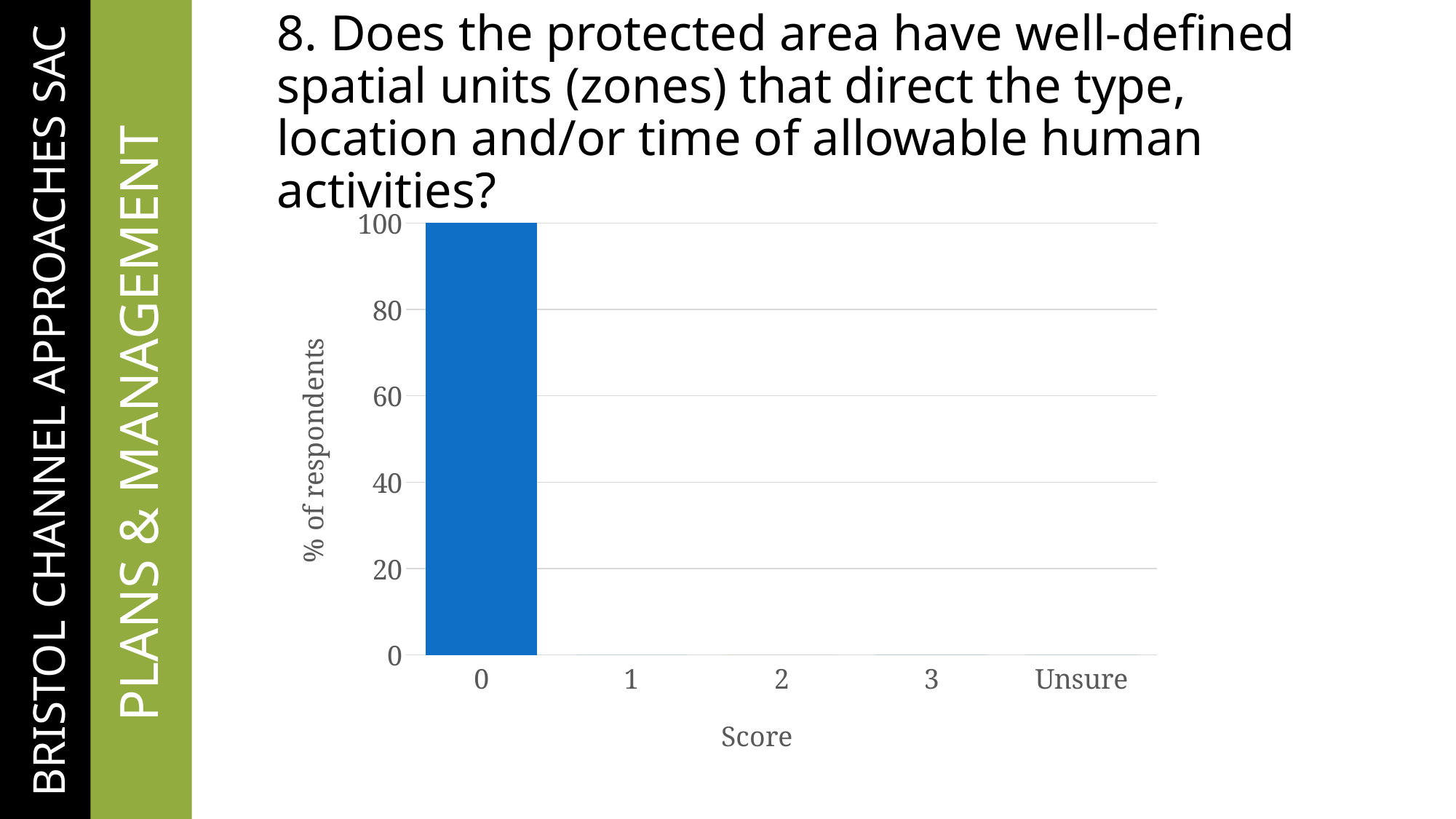
What is the label of the x axis? Score What type of chart is shown on the slide? bar chart What is the % of respondents for score 2? 0 What is the difference in % of respondents between score 0 and score 1? 100 How many score categories are shown on the x axis? 5 Is the value for score 0 greater or less than 80? greater What is the label of the y axis? % of respondents Which score category has the highest % of respondents? 0 What is the % of respondents for score 0? 100 What is the highest value shown on the y axis? 100 Which has a larger % of respondents, score 0 or score 3? score 0 What is the % of respondents for Unsure? 0